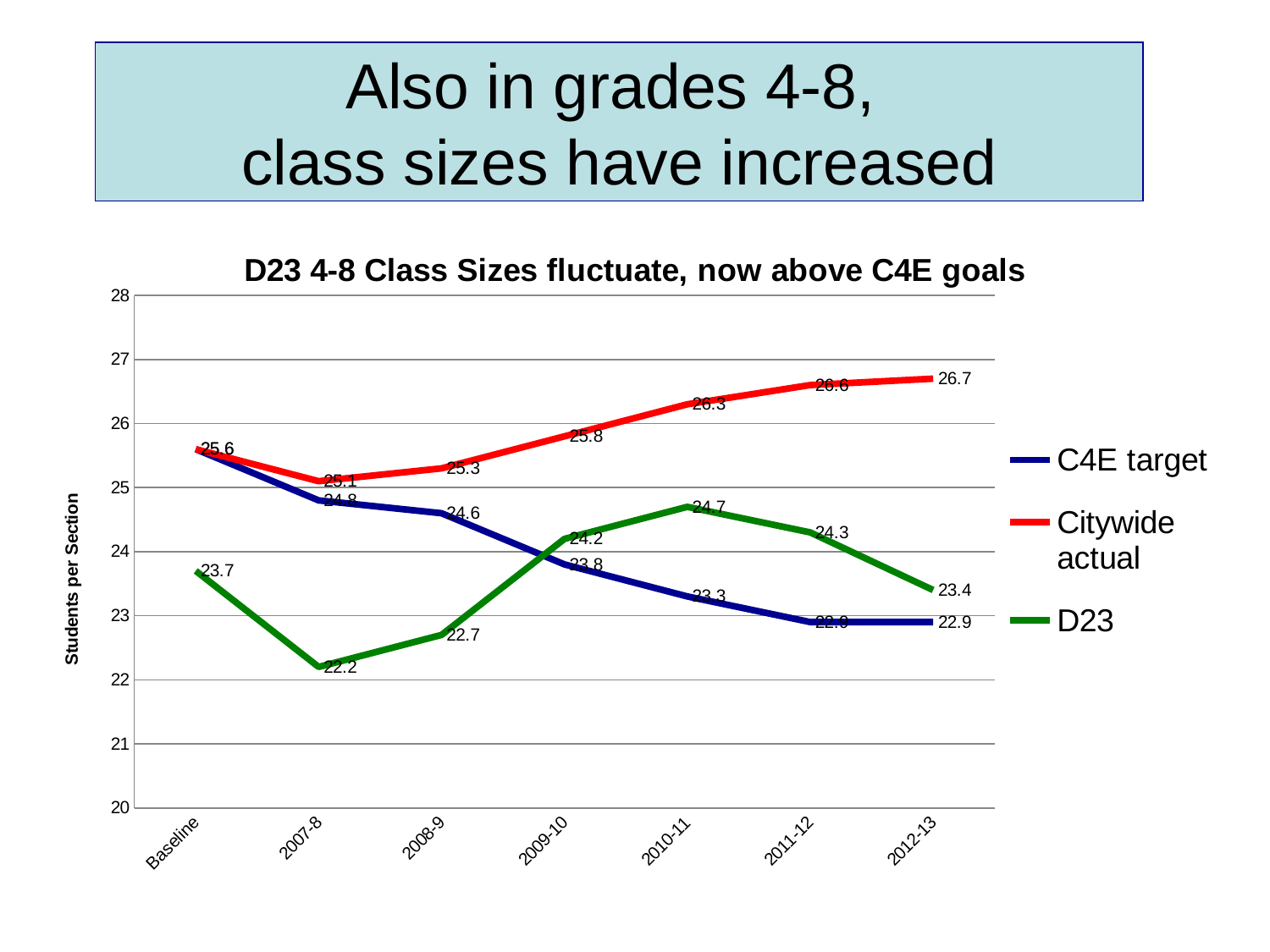
What is the difference between the Citywide actual and D23 values in 2012-13? 3.3 How many series does the legend list? 3 In which year does the D23 series reach its lowest value? 2007-8 Is the Citywide actual value for 2010-11 greater or less than 26? greater In which year does the D23 series reach its highest value? 2010-11 What kind of chart is shown on the slide? line chart How many time points are plotted along the x axis? 7 In 2012-13, which is larger: the D23 value or the C4E target value? D23 What is the D23 value for 2007-8? 22.2 What is the Citywide actual value for 2012-13? 26.7 Does the C4E target series rise or fall from Baseline to 2012-13? fall What is the C4E target value for 2012-13? 22.9